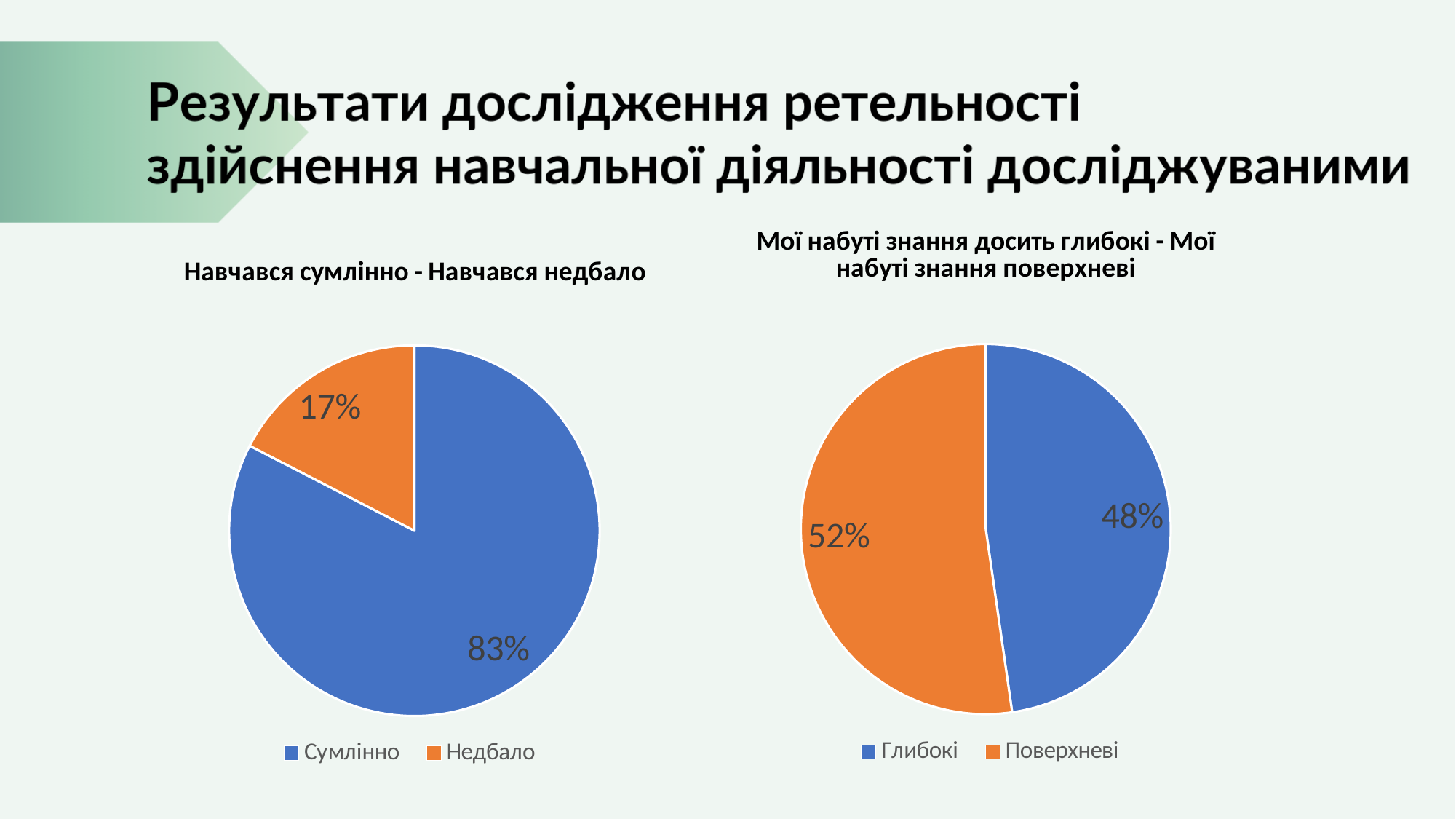
In the left chart (Навчався сумлінно - Навчався недбало), what share is labelled for Недбало? 17% In the right chart, which is larger: Глибокі or Поверхневі? Поверхневі How many entries does the legend of the left chart list? 2 How many slices does the right chart have? 2 In the left chart, what is the difference in percentage points between Сумлінно and Недбало? 66 In the right chart (Мої набуті знання досить глибокі - Мої набуті знання поверхневі), what share is labelled for Поверхневі? 52% In the left chart (Навчався сумлінно - Навчався недбало), what share is labelled for Сумлінно? 83% In the right chart, what is the difference in percentage points between Поверхневі and Глибокі? 4 What type of chart is the left chart? Pie chart In the right chart, which slice is the smallest? Глибокі In the left chart, which slice is the largest? Сумлінно In the right chart (Мої набуті знання досить глибокі - Мої набуті знання поверхневі), what share is labelled for Глибокі? 48%